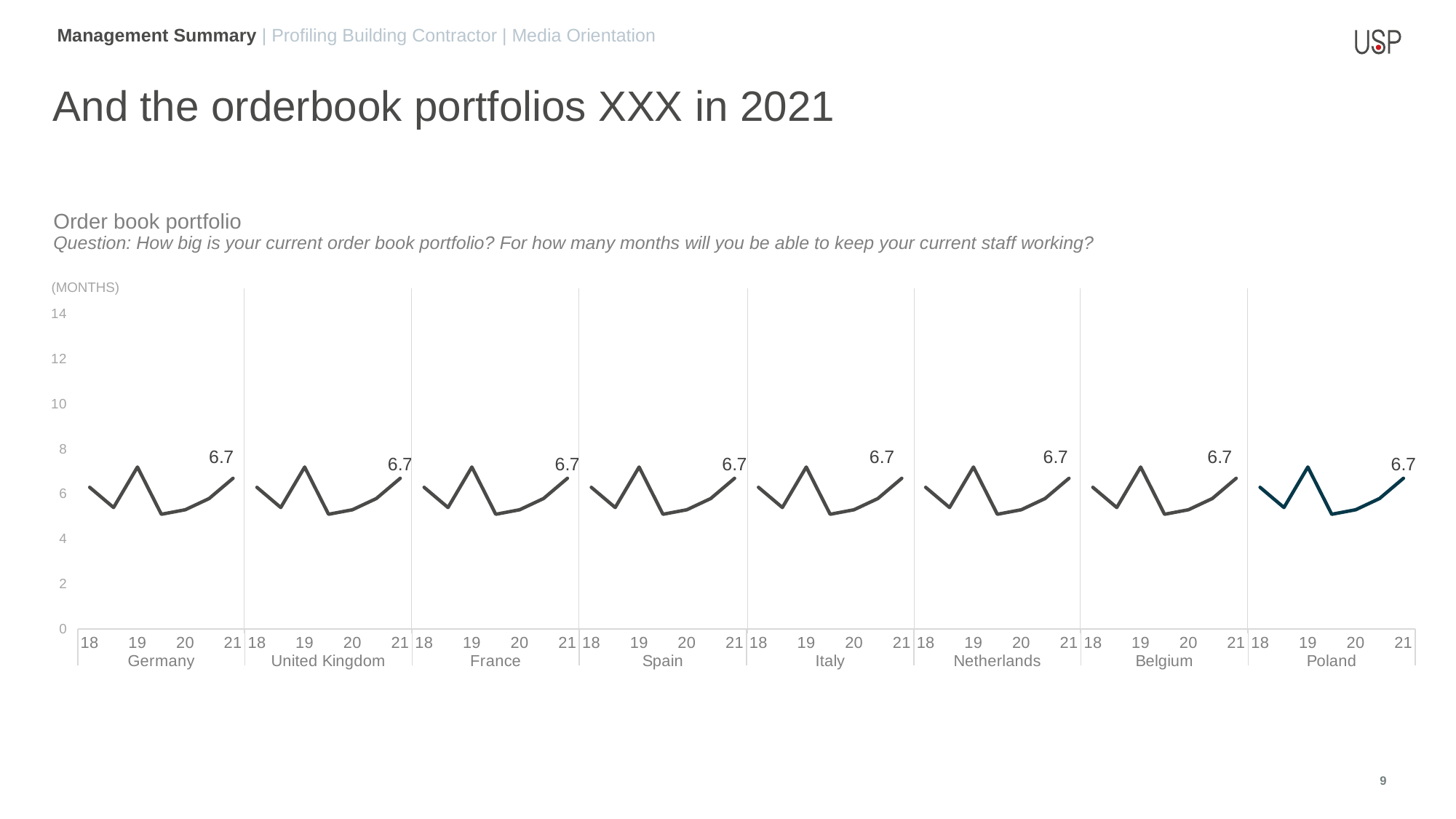
What kind of chart is used to show the order book portfolio? line chart Does the value for France rise or fall from 20 to 21? rise What is the order book portfolio value for Germany in 21? 6.7 How many years are plotted for each country? 4 Is the value for Germany in 20 greater or less than 6? less Which country's line is drawn in a different colour from the others? Poland What is the order book portfolio value for Poland in 21? 6.7 How many countries are shown in the chart? 8 What value is labelled for the Netherlands in 21? 6.7 Is the value for United Kingdom in 19 greater or less than 6? greater What unit is shown on the y axis of the chart? months Which is larger for Spain: the value in 19 or the value in 20? 19